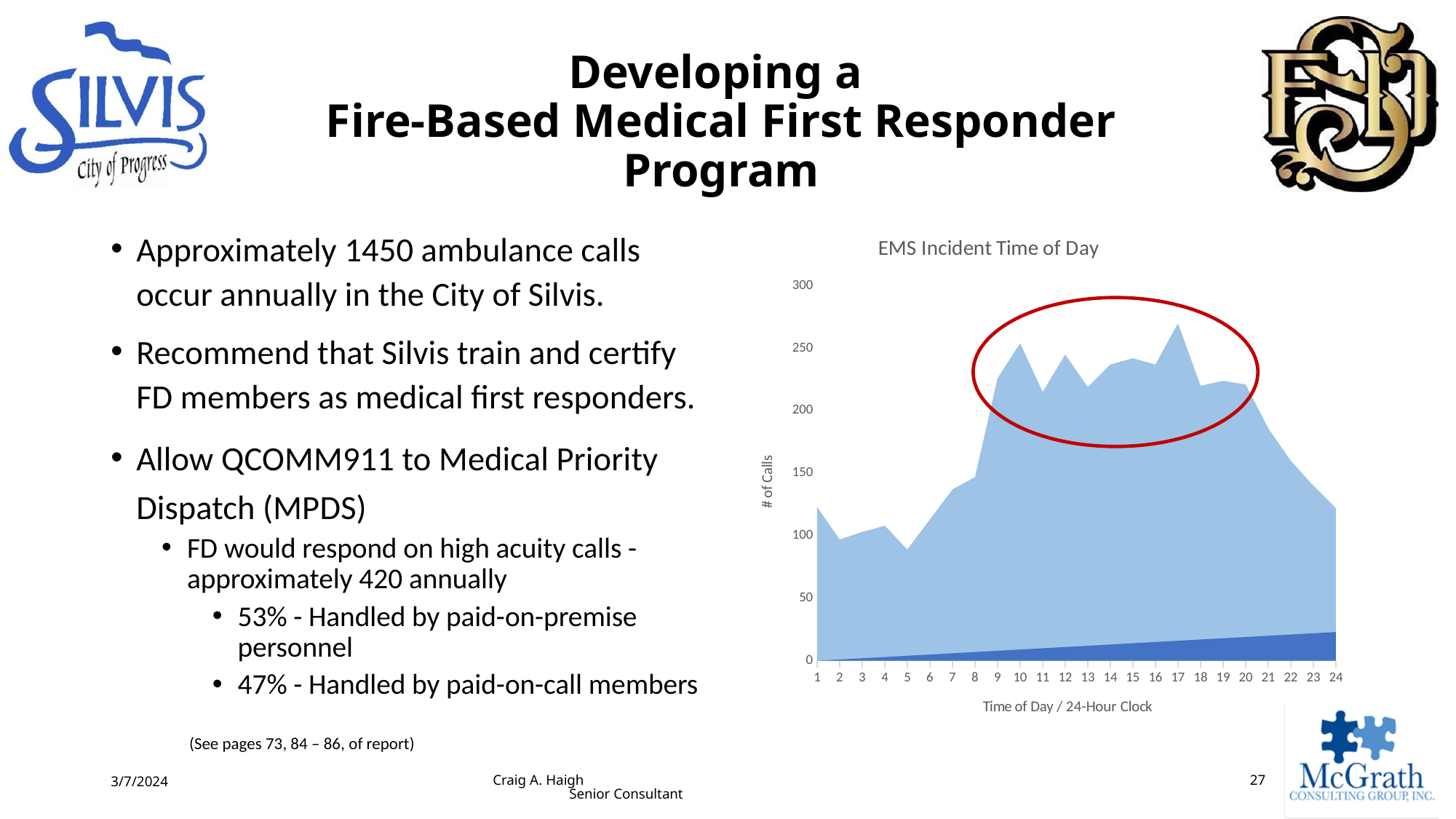
Is the number of calls at hour 10 greater or less than 200? greater Do the number of calls rise or fall from hour 5 to hour 10? rise Is the number of calls at hour 17 greater or less than 250? greater Is the number of calls at hour 5 greater or less than 100? less What kind of chart is shown on the slide? Area chart How many time-of-day points are plotted along the x axis of the chart? 24 Which hour has more calls, hour 17 or hour 5? 17 What is the title of the chart? EMS Incident Time of Day At which hour of the day does the number of calls reach its highest point? 17 Do the number of calls rise or fall from hour 17 to hour 24? fall What is the label of the vertical axis of the chart? # of Calls